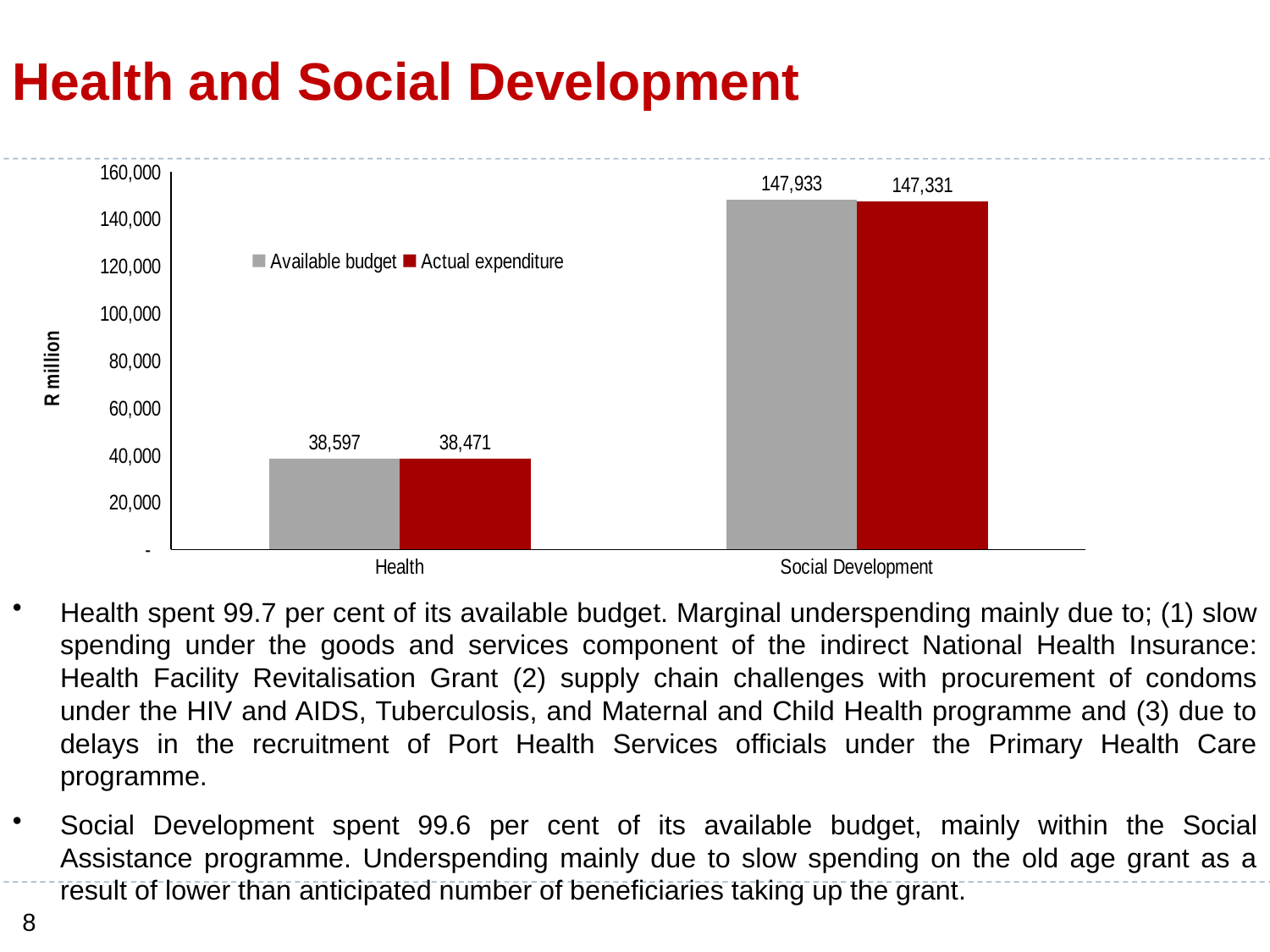
How many series does the legend list? 2 Which category has the higher Available budget? Social Development What is the difference between the Available budget and Actual expenditure for Health? 126 What is the Available budget value for Social Development? 147,933 What kind of chart is shown on the slide? Bar chart What is the Actual expenditure value for Social Development? 147,331 What is the difference between the Available budget and Actual expenditure for Social Development? 602 What is the Available budget value for Health? 38,597 What is the Actual expenditure value for Health? 38,471 How many categories are shown on the x axis? 2 Which category has the lowest Actual expenditure? Health Is the Actual expenditure for Social Development greater or less than 140,000? greater